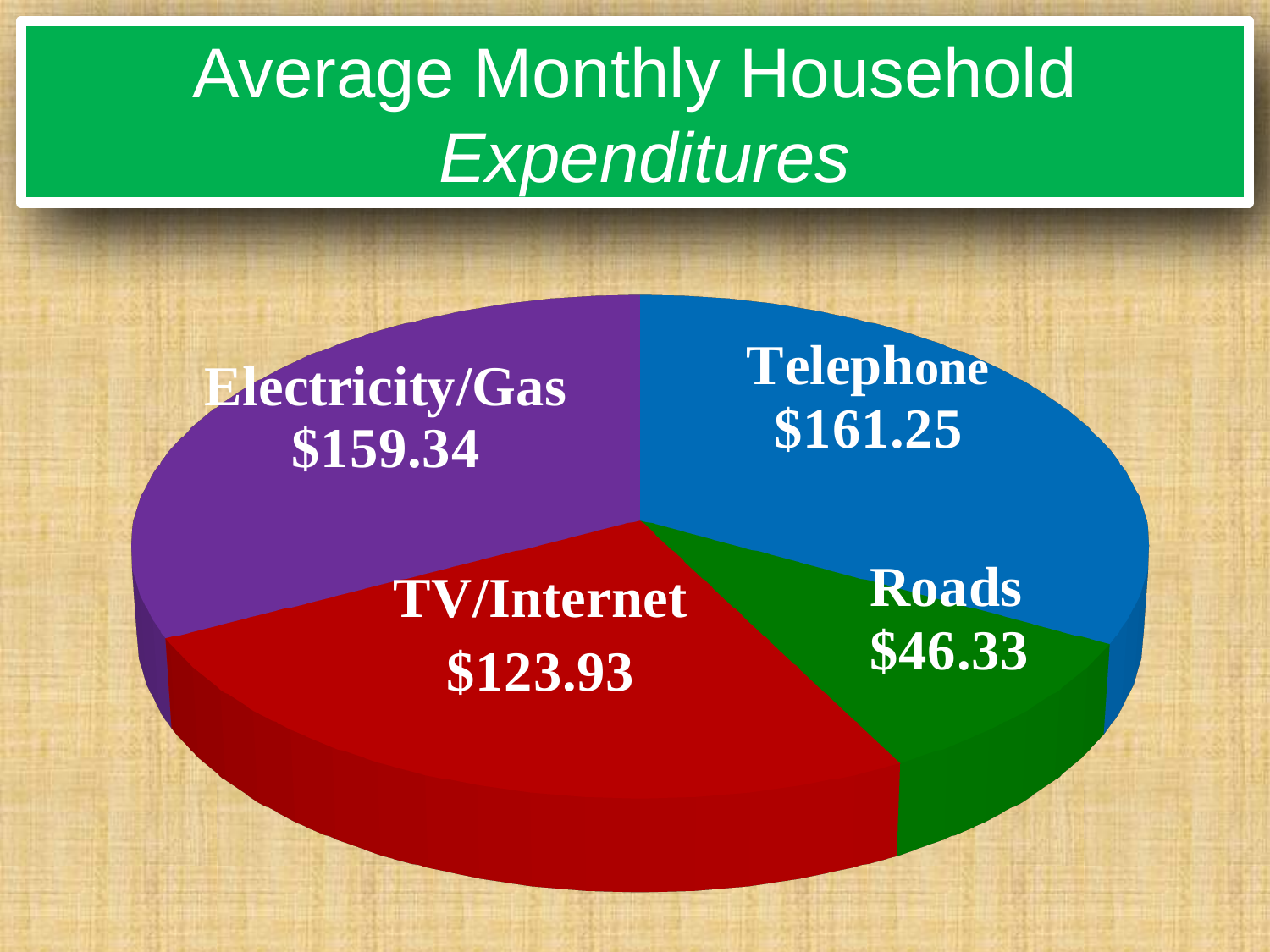
How many categories are shown in the pie chart? 4 What is the total of all four expenditure categories? $490.85 How much more is spent on TV/Internet than on Roads? $77.60 What is the average monthly household expenditure on Telephone? $161.25 What is the value shown for TV/Internet? $123.93 What is the value shown for Roads? $46.33 Which category has the lowest expenditure? Roads What kind of chart is shown on the slide? Pie chart Which category has the highest expenditure? Telephone What is the difference between the Telephone and Electricity/Gas expenditures? $1.91 Which is larger, the expenditure on Electricity/Gas or on TV/Internet? Electricity/Gas What is the value shown for Electricity/Gas? $159.34